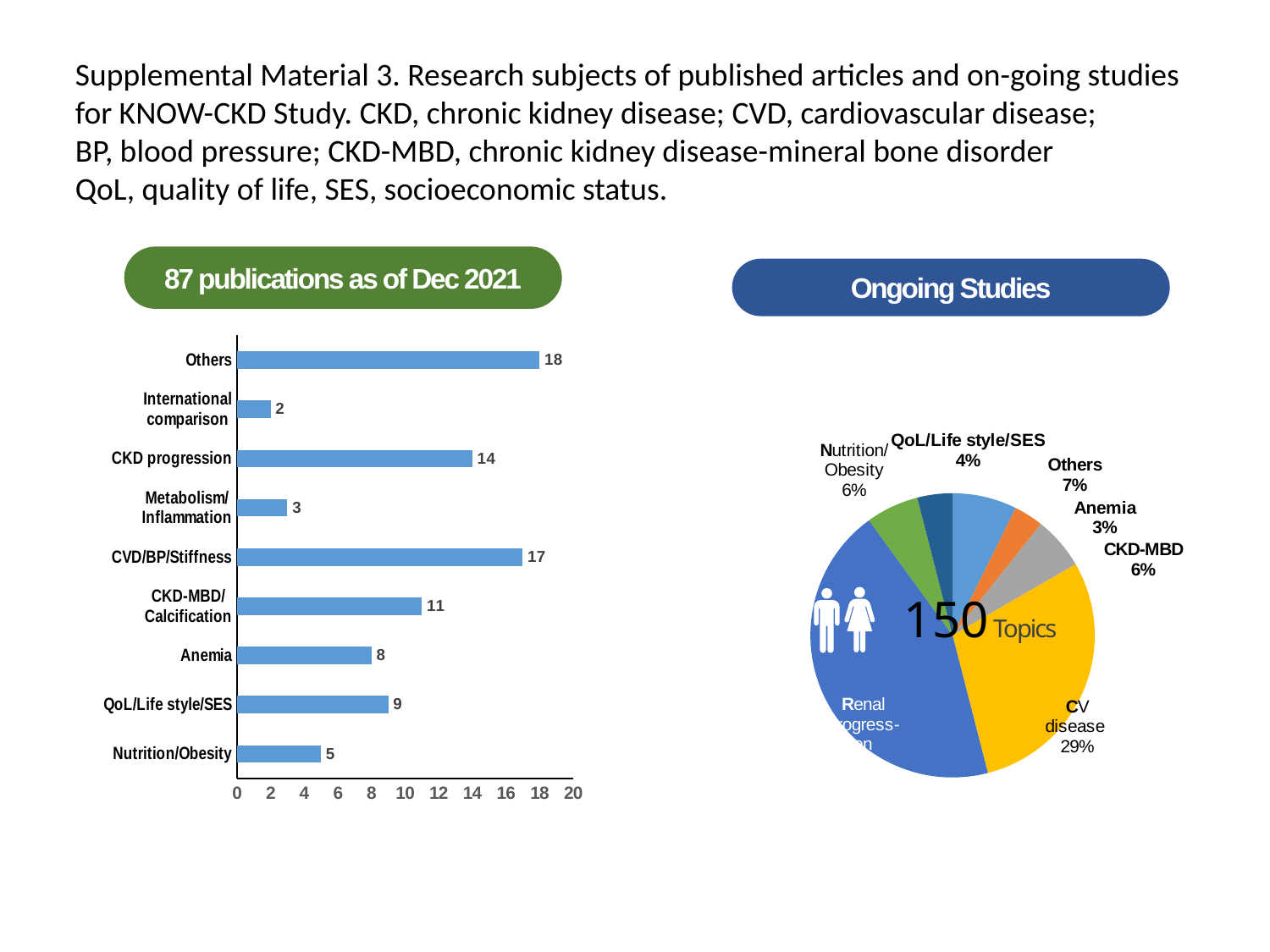
What type of chart is used under the heading '87 publications as of Dec 2021'? Bar chart In the bar chart titled '87 publications as of Dec 2021', which is larger: Anemia or QoL/Life style/SES? QoL/Life style/SES In the bar chart titled '87 publications as of Dec 2021', how many categories are shown? 9 What number is displayed in the centre of the pie chart under 'Ongoing Studies'? 150 In the bar chart titled '87 publications as of Dec 2021', which category has the highest value? Others In the pie chart under 'Ongoing Studies', what percentage is shown for Anemia? 3% In the bar chart titled '87 publications as of Dec 2021', which category has the lowest value? International comparison In the bar chart titled '87 publications as of Dec 2021', what is the value for CVD/BP/Stiffness? 17 In the pie chart under 'Ongoing Studies', which is larger: Others or CKD-MBD? Others In the pie chart under 'Ongoing Studies', what share does CV disease have? 29% In the bar chart titled '87 publications as of Dec 2021', how many publications are in the CKD progression category? 14 In the bar chart titled '87 publications as of Dec 2021', what is the difference between the values for Others and Nutrition/Obesity? 13